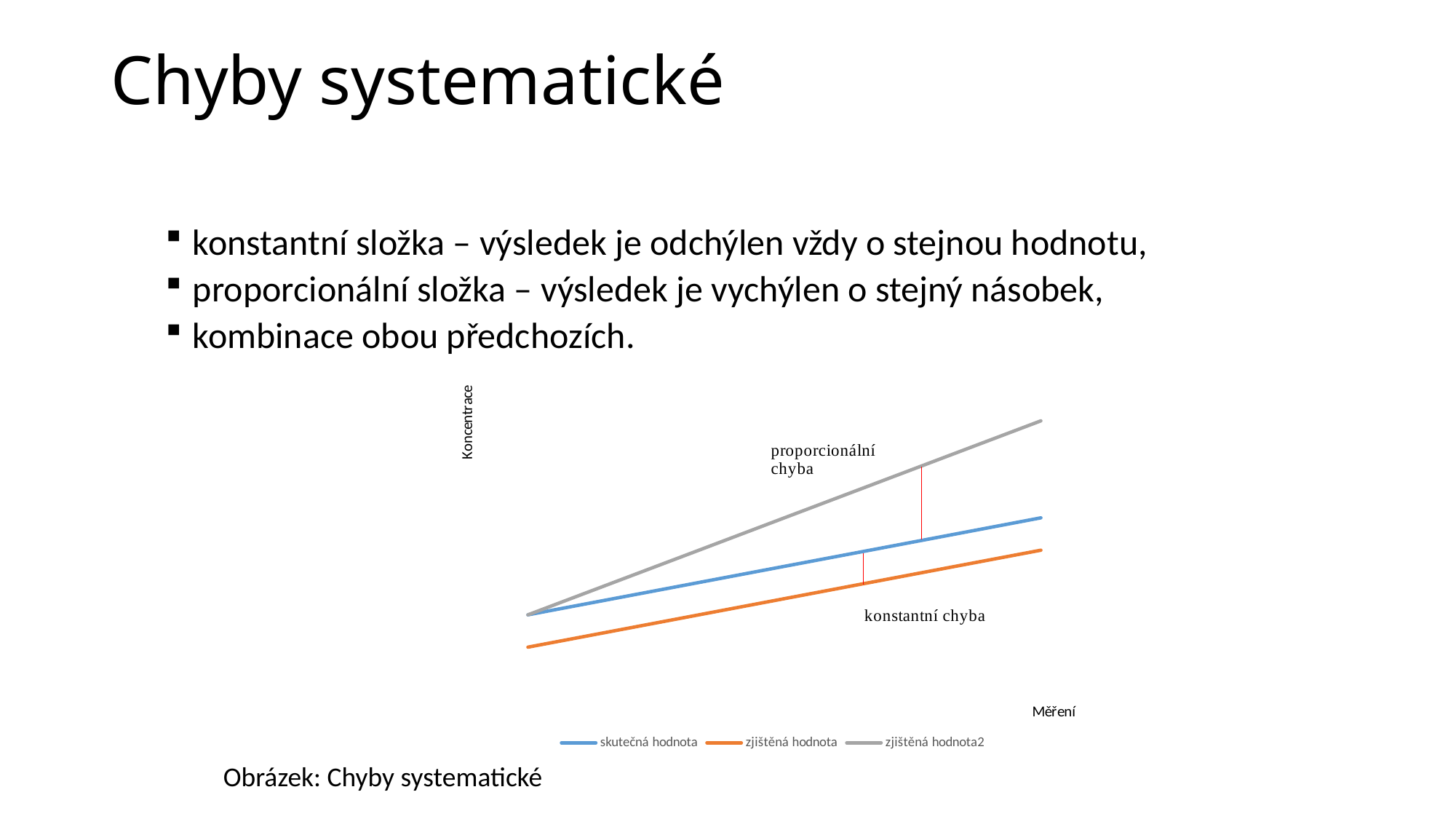
What kind of chart is shown on the slide? line chart What colour is the line for the series 'zjištěná hodnota'? orange Do the values of the series 'skutečná hodnota' rise or fall along the x axis? rise Which series has the highest value at the right end of the chart? zjištěná hodnota2 Which series has the lowest value at the right end of the chart? zjištěná hodnota Do the values of the series 'zjištěná hodnota' rise or fall along the x axis? rise At the right end of the chart, which is larger: the value of 'skutečná hodnota' or the value of 'zjištěná hodnota'? skutečná hodnota At the right end of the chart, which is larger: the value of 'zjištěná hodnota2' or the value of 'skutečná hodnota'? zjištěná hodnota2 How many series does the chart legend list? 3 Which series has the lowest value at the left end of the chart? zjištěná hodnota What is the title of the vertical axis of the chart? Koncentrace Do the values of the series 'zjištěná hodnota2' rise or fall along the x axis? rise